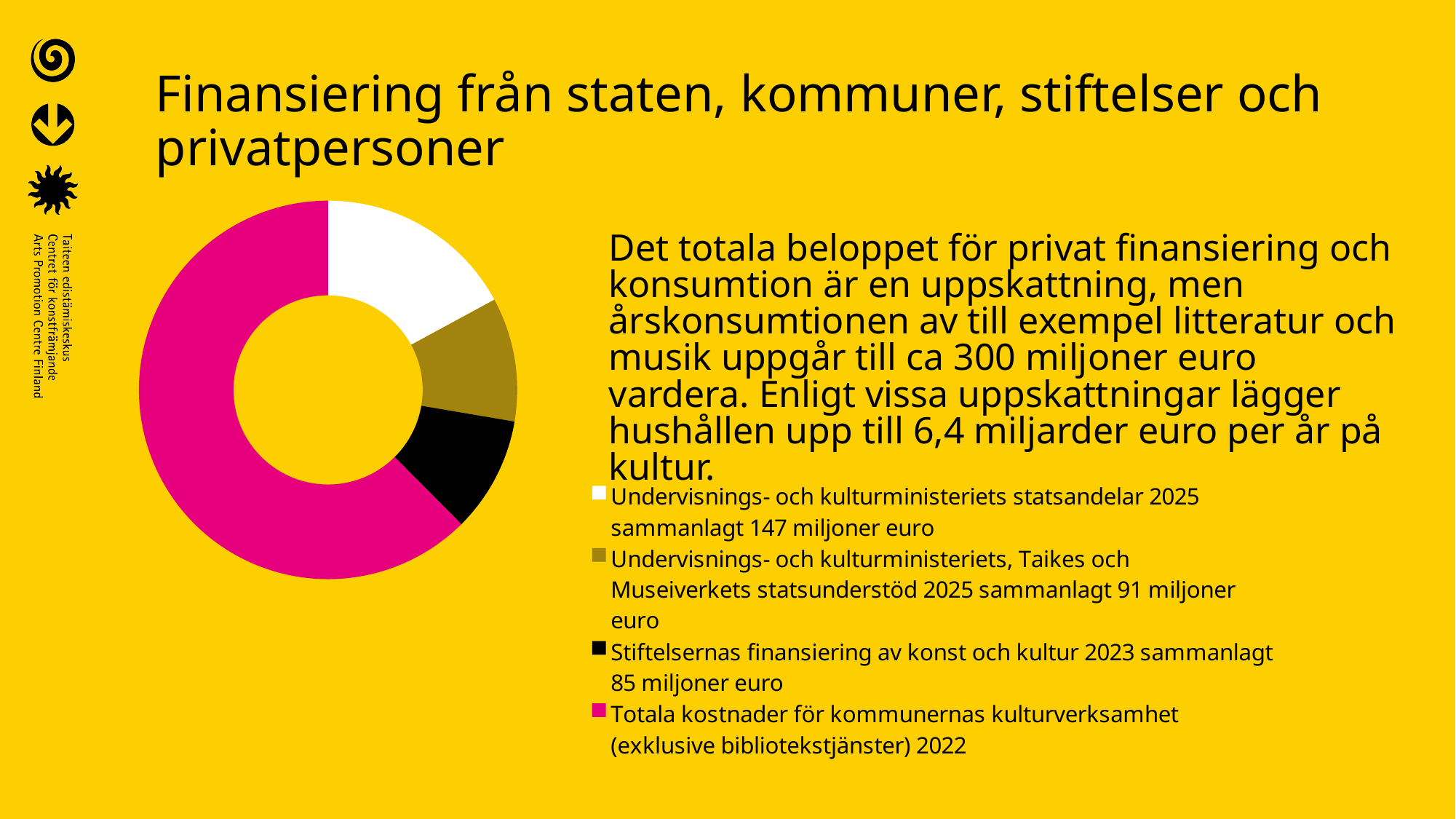
What is the total amount for Stiftelsernas finansiering av konst och kultur 2023? 85 miljoner euro Which category takes up the largest slice of the doughnut chart? Totala kostnader för kommunernas kulturverksamhet (exklusive bibliotekstjänster) 2022 What colour is the slice for Totala kostnader för kommunernas kulturverksamhet? pink (magenta) What is the difference in miljoner euro between the statsandelar 2025 (147) and Stiftelsernas finansiering 2023 (85)? 62 miljoner euro What kind of chart is shown on the slide? doughnut chart Which category has the smallest slice of the doughnut chart? Stiftelsernas finansiering av konst och kultur 2023 Which is larger: the statsandelar 2025 or Stiftelsernas finansiering av konst och kultur 2023? Undervisnings- och kulturministeriets statsandelar 2025 How many slices does the doughnut chart have? 4 What is the total amount for Undervisnings- och kulturministeriets statsandelar 2025? 147 miljoner euro What is the total amount for Undervisnings- och kulturministeriets, Taikes och Museiverkets statsunderstöd 2025? 91 miljoner euro How many entries does the legend list? 4 What is the difference in miljoner euro between the statsandelar 2025 (147) and the statsunderstöd 2025 (91)? 56 miljoner euro